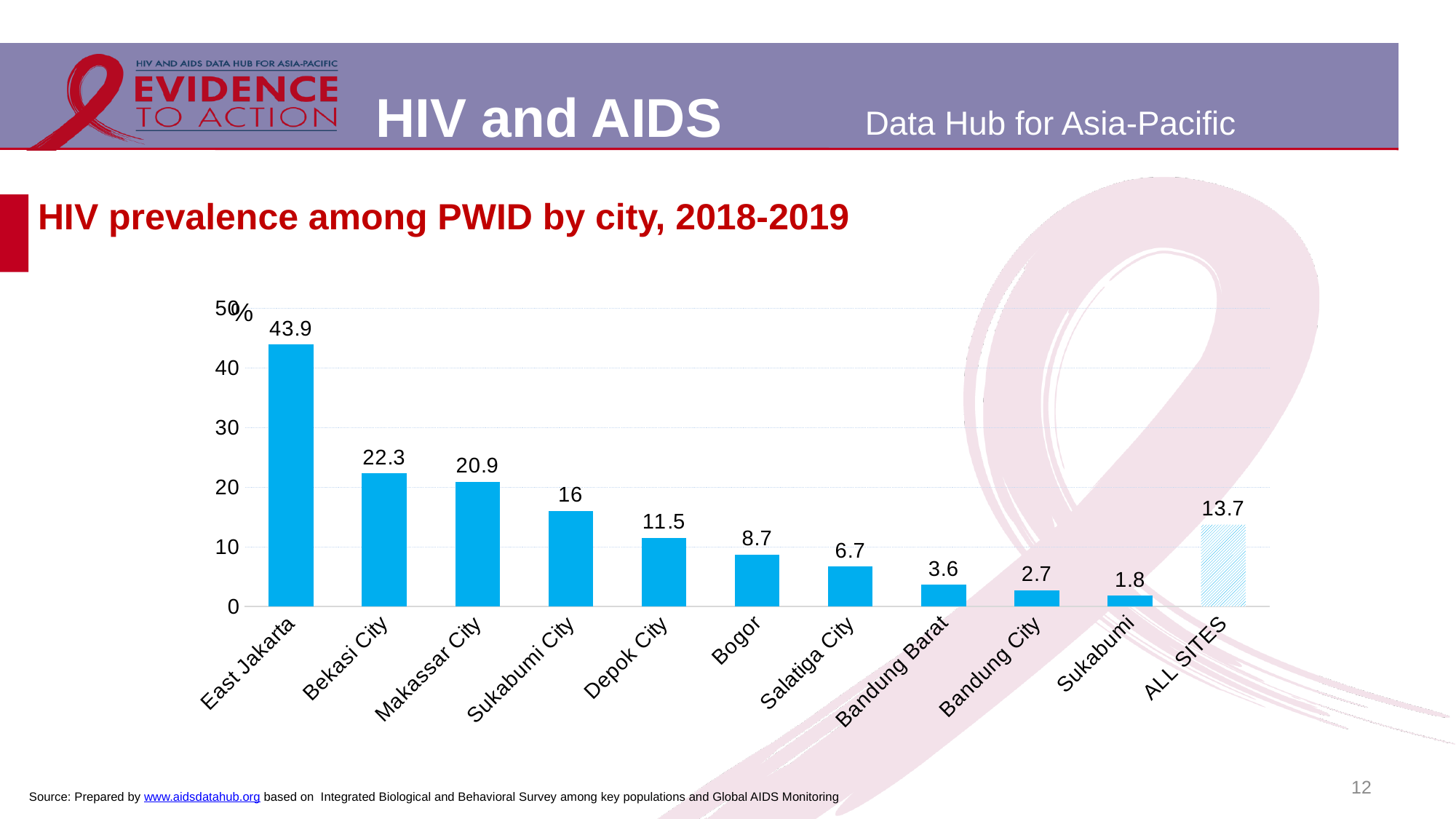
Which city has the lowest HIV prevalence among PWID? Sukabumi What kind of chart is shown on the slide? bar chart How many bars are shown in the chart? 11 Is the value for Sukabumi City greater or less than 20? less What is the HIV prevalence value shown for East Jakarta? 43.9 Do the city values rise or fall from East Jakarta to Sukabumi along the x axis? fall Which city has the highest HIV prevalence among PWID? East Jakarta What is the difference between the values for Bekasi City and Makassar City? 1.4 Which has a higher value, Bogor or Salatiga City? Bogor What value is shown for ALL SITES? 13.7 What is the title of the chart? HIV prevalence among PWID by city, 2018-2019 What is the value shown for Depok City? 11.5